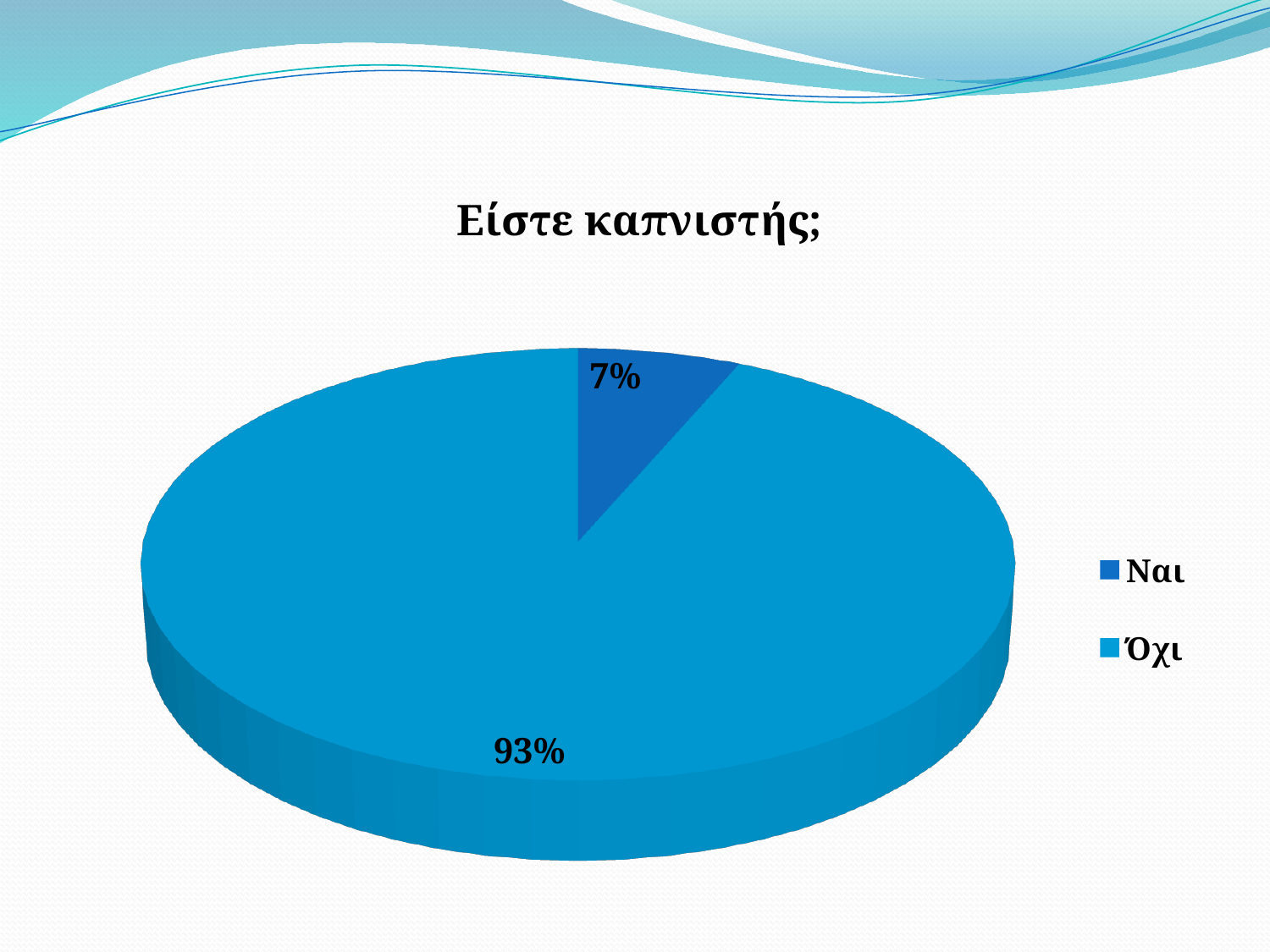
Which category has the smallest share of the pie? Ναι What is the title of the chart? Είστε καπνιστής; What percentage of respondents answered Ναι? 7% What share of the pie does the Ναι slice represent? 7% What is the difference in percentage points between Όχι and Ναι? 86 How many entries does the legend list? 2 Which category has the largest share of the pie? Όχι What kind of chart is shown on the slide? Pie chart How many categories does the pie chart show? 2 Which legend entry is shown in the lighter blue colour? Όχι What percentage of respondents answered Όχι? 93% Which is larger, the share for Ναι or the share for Όχι? Όχι